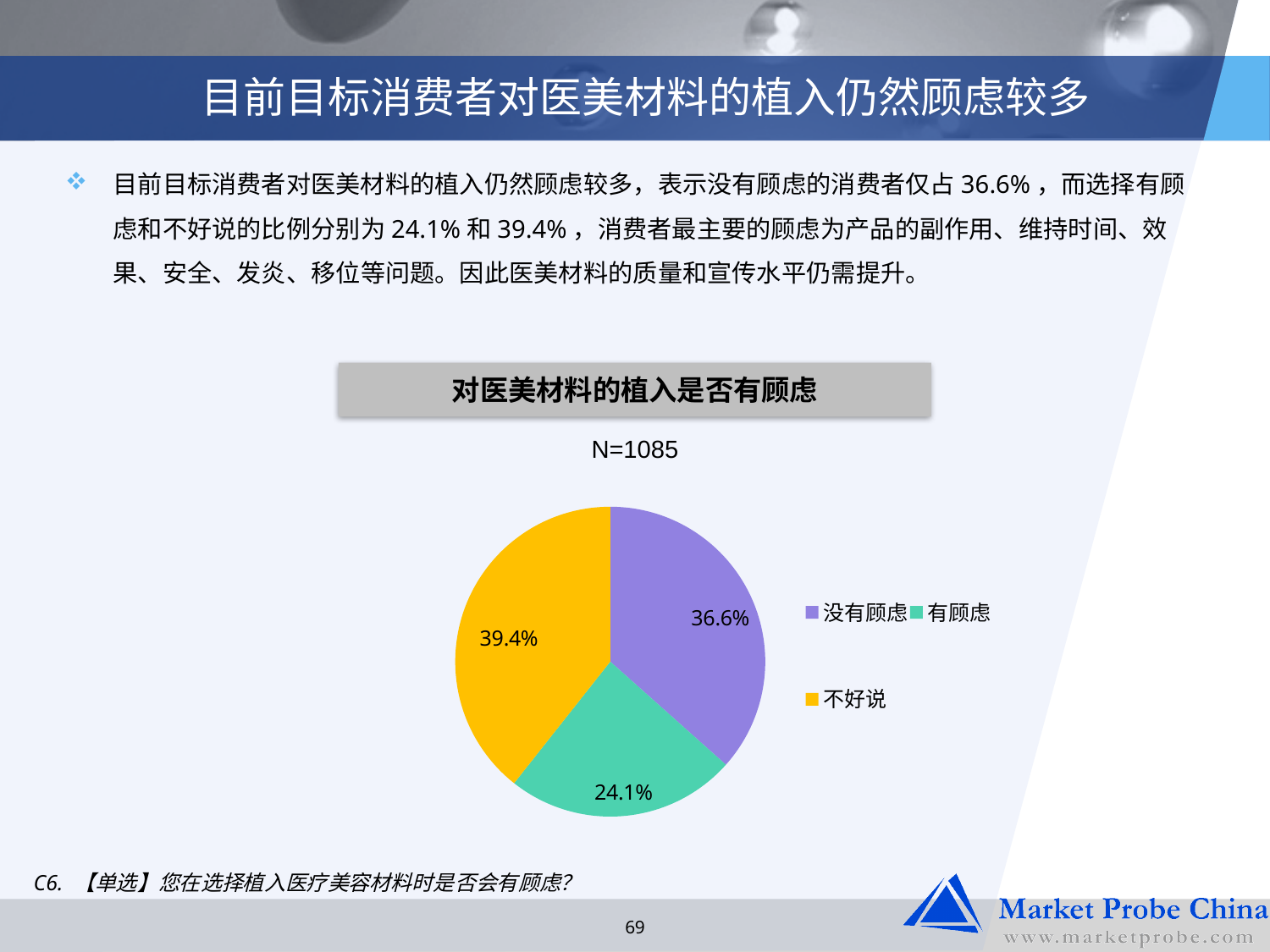
Which category has the smallest share of the pie? 有顾虑 What is the value for 不好说? 39.4% What is the value for 没有顾虑? 36.6% How many categories does the pie chart have? 3 What type of chart is shown on the slide? Pie chart What is the title of the chart? 对医美材料的植入是否有顾虑 Which is larger, the share of 没有顾虑 or the share of 有顾虑? 没有顾虑 Which category has the largest share of the pie? 不好说 What is the sample size (N) shown for the chart? N=1085 What is the difference between the shares of 不好说 and 没有顾虑? 2.8% What is the difference between the shares of 不好说 and 有顾虑? 15.3% What is the value for 有顾虑? 24.1%